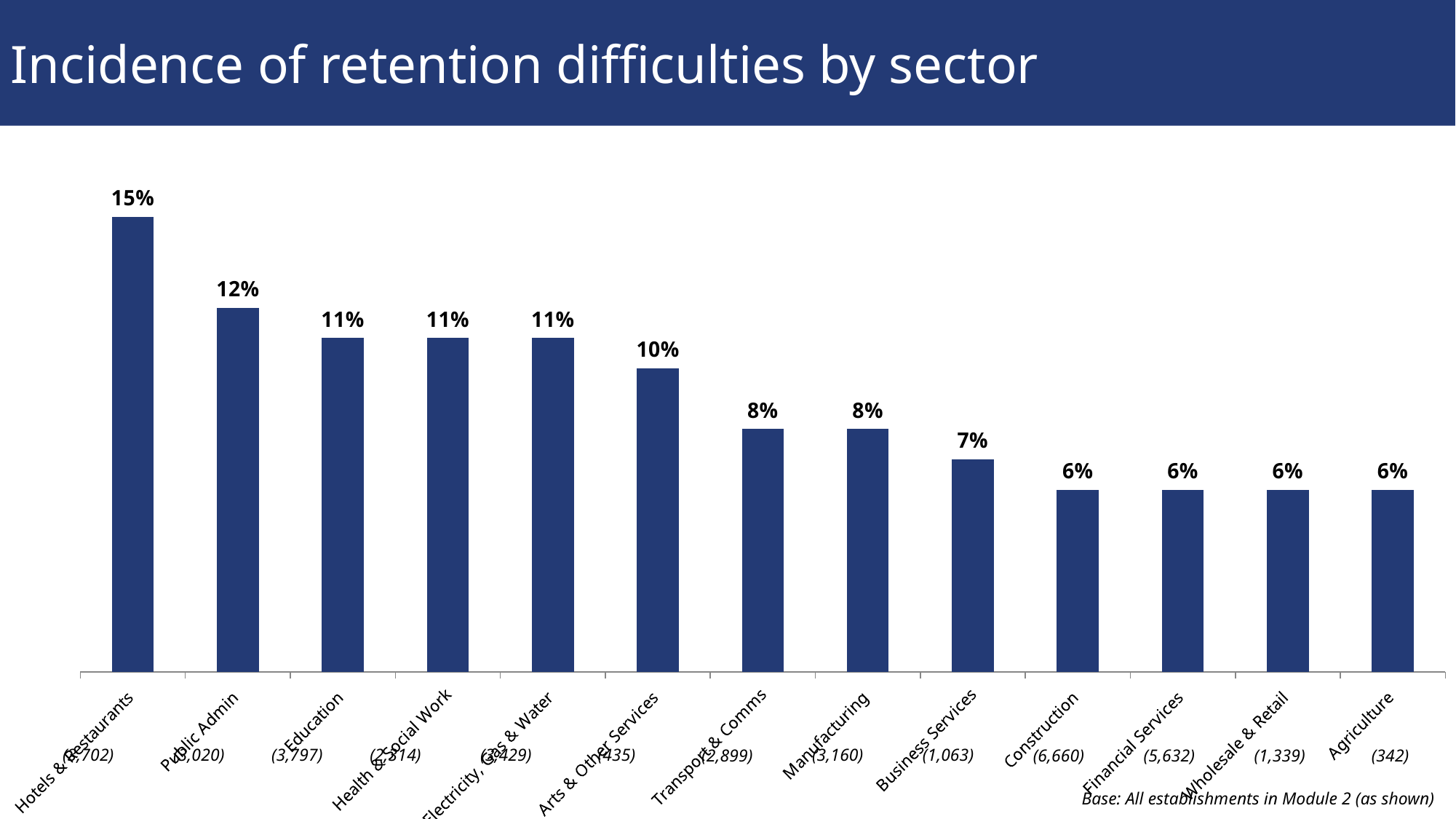
What is the value for Public Admin? 12% What is the difference between the values for Education and Construction? 5% What is the value for Arts & Other Services? 10% Which is larger, the value for Transport & Comms or the value for Business Services? Transport & Comms What is the difference between the values for Hotels & Restaurants and Public Admin? 3% Which sector has the highest incidence of retention difficulties? Hotels & Restaurants What is the value for Manufacturing? 8% What is the value for Hotels & Restaurants? 15% How many sectors are shown in the chart? 13 What is the title of the chart? Incidence of retention difficulties by sector What kind of chart is shown on the slide? Bar chart What is the value for Business Services? 7%